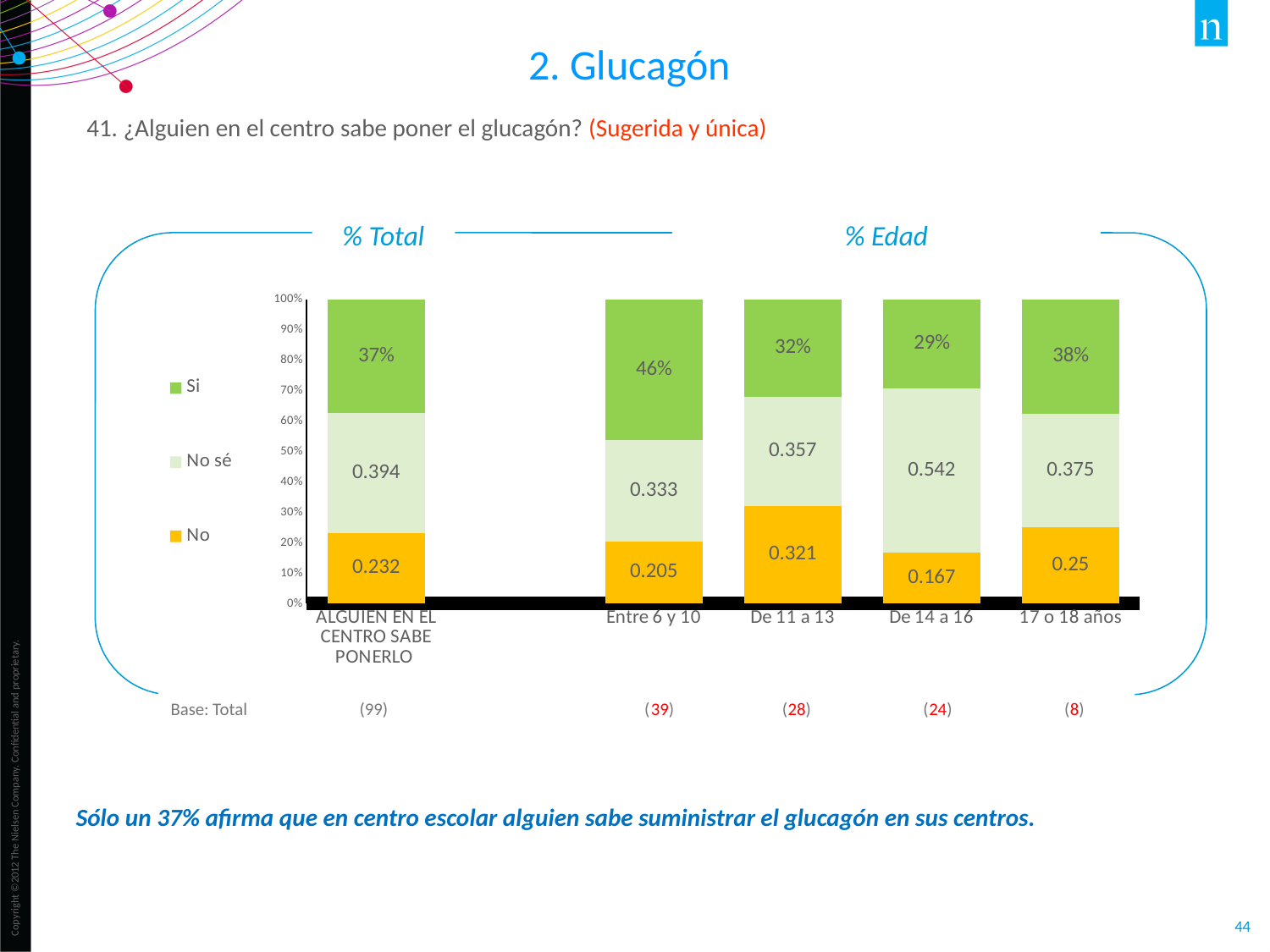
What is the value of the 'No' segment for the 'De 11 a 13' bar? 0.321 Is the 'No' value for 'De 11 a 13' larger or smaller than the 'No' value for '17 o 18 años'? larger What is the value of the 'Si' segment for the 'Entre 6 y 10' bar? 46% What is the value of the 'No' segment for the 'ALGUIEN EN EL CENTRO SABE PONERLO' bar? 0.232 What is the value of the 'No sé' segment for the 'De 14 a 16' bar? 0.542 How many bars (categories) are plotted in the chart? 5 Which category has the lowest 'No' value? De 14 a 16 How many series does the legend list? 3 Which legend entry is shown in yellow? No Which category has the highest 'Si' value? Entre 6 y 10 What kind of chart is shown on the slide? Stacked bar chart What is the difference between the 'Si' value for 'Entre 6 y 10' and the 'Si' value for 'De 14 a 16'? 17%